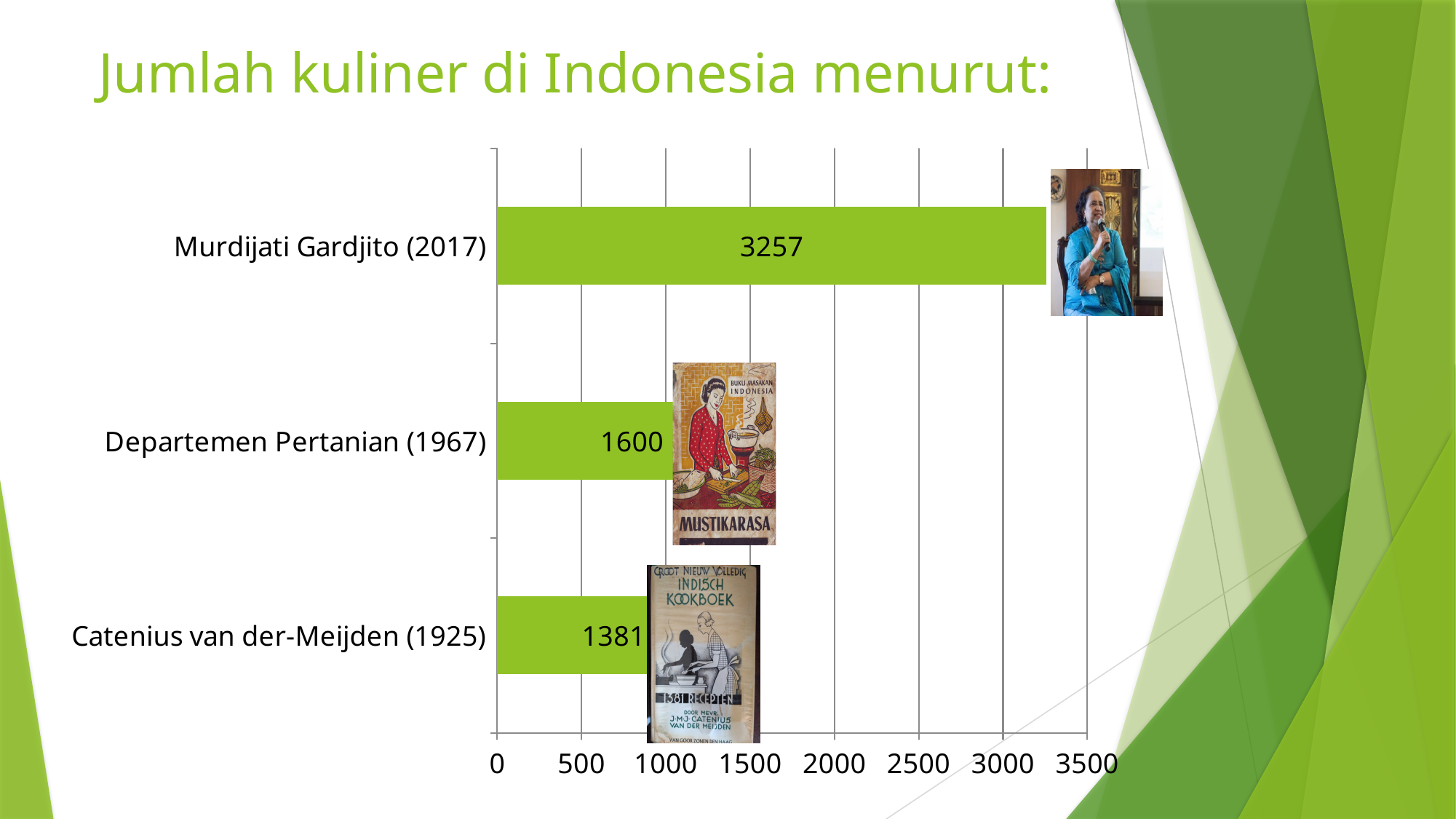
Which source has the lowest value? Catenius van der-Meijden (1925) How many categories are shown in the chart? 3 What is the difference between the values for Departemen Pertanian (1967) and Catenius van der-Meijden (1925)? 219 What is the value for Departemen Pertanian (1967)? 1600 What is the title of the slide? Jumlah kuliner di Indonesia menurut: Which source has the highest value? Murdijati Gardjito (2017) What is the value for Murdijati Gardjito (2017)? 3257 What is the value for Catenius van der-Meijden (1925)? 1381 What is the difference between the values for Murdijati Gardjito (2017) and Departemen Pertanian (1967)? 1657 Is the value for Murdijati Gardjito (2017) greater or less than 3000? greater What kind of chart is shown on the slide? bar chart Which is larger, the value for Departemen Pertanian (1967) or Catenius van der-Meijden (1925)? Departemen Pertanian (1967)